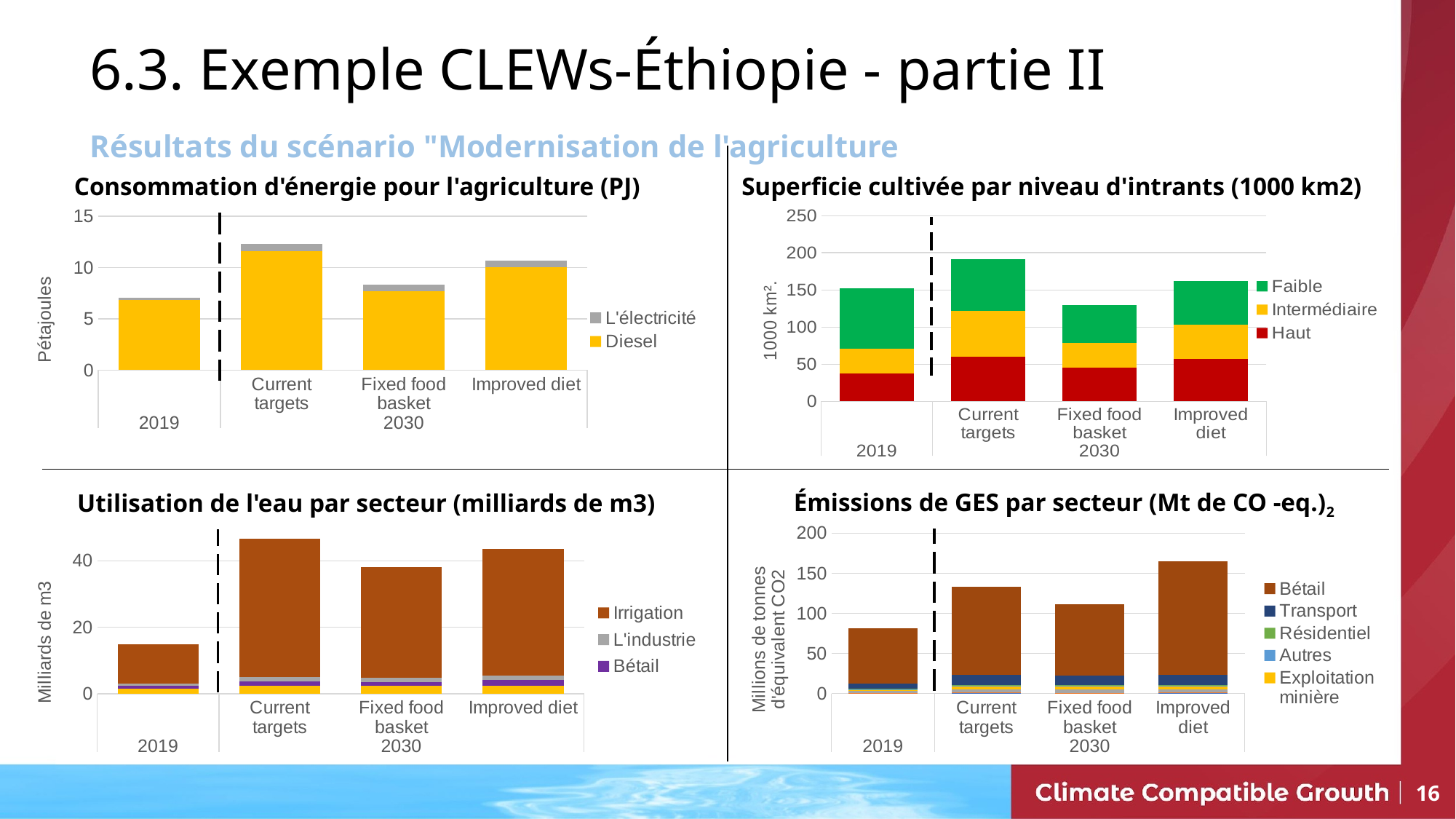
What kind of chart is "Consommation d'énergie pour l'agriculture (PJ)"? stacked bar chart In the chart "Utilisation de l'eau par secteur (milliards de m3)", how many categories are shown on the x axis? 4 In the chart "Émissions de GES par secteur", how many series does the legend list? 5 In the chart "Consommation d'énergie pour l'agriculture (PJ)", how many series does the legend list? 2 In the chart "Consommation d'énergie pour l'agriculture (PJ)", which scenario has the highest total energy consumption? Current targets In the chart "Consommation d'énergie pour l'agriculture (PJ)", is the total for 2019 greater or less than 10? less In the chart "Superficie cultivée par niveau d'intrants (1000 km2)", is the total for Current targets greater or less than 150? greater In the chart "Superficie cultivée par niveau d'intrants (1000 km2)", which scenario has the lowest total cultivated area? Fixed food basket In the chart "Émissions de GES par secteur", is the total for 2019 greater or less than 100? less In the chart "Superficie cultivée par niveau d'intrants (1000 km2)", how many series does the legend list? 3 In the chart "Émissions de GES par secteur", which scenario has the highest total emissions? Improved diet In the chart "Utilisation de l'eau par secteur (milliards de m3)", which scenario has the lowest total water use? 2019